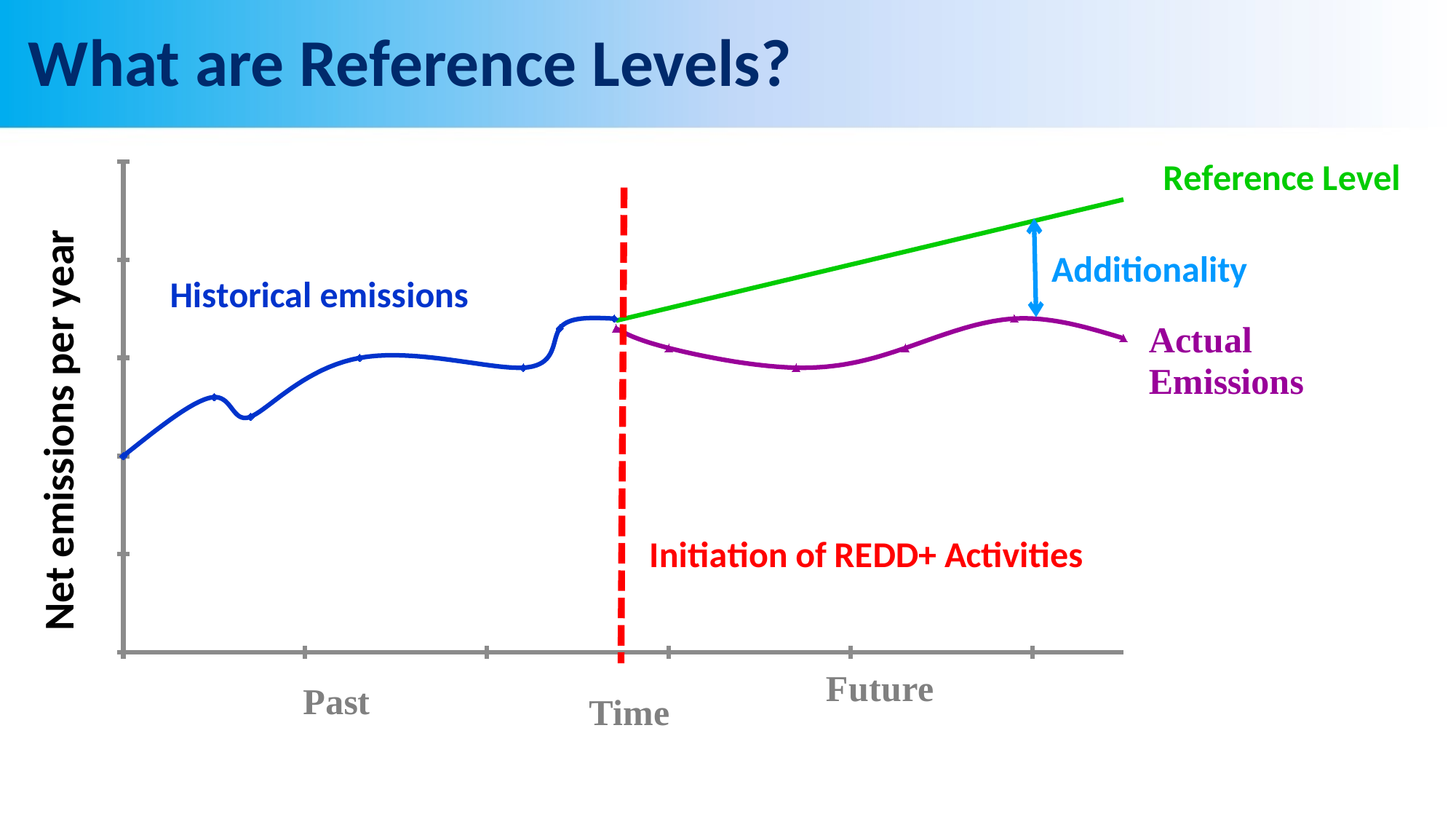
Which line is labelled 'Historical emissions': the one in the Past or the one in the Future? Past Which line is plotted in green? Reference Level What does the red dashed vertical line mark? Initiation of REDD+ Activities Does the Reference Level line rise or fall over the Future period? rises Which line is plotted in purple? Actual Emissions What kind of chart is shown on the slide? line chart What is the label of the horizontal axis? Time Overall, do Historical emissions rise or fall from the start of the Past period to the Initiation of REDD+ Activities? rise How many labelled lines (series) are plotted on the chart? 3 What is the name of the gap between the Reference Level and Actual Emissions lines? Additionality What is the label of the vertical axis? Net emissions per year In the Future period, which line is higher: Reference Level or Actual Emissions? Reference Level